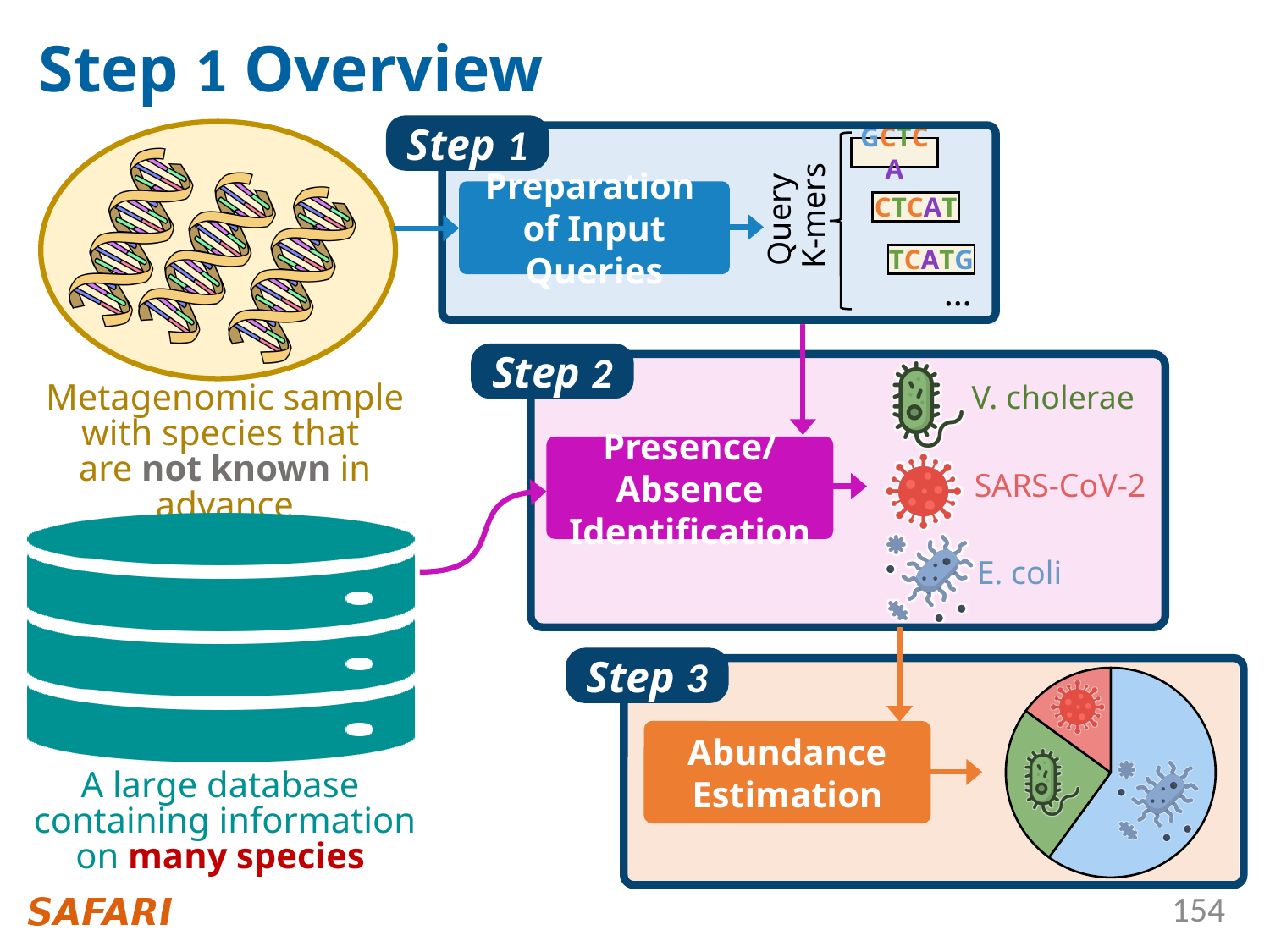
What kind of chart is shown in the Step 3 box? pie chart Which step's box contains the pie chart on the slide? Step 3 How many slices does the pie chart in the Step 3 box have? 3 What is the label of the box that points to the pie chart in Step 3? Abundance Estimation Which colour slice is the largest in the pie chart in the Step 3 box? blue In the pie chart in the Step 3 box, which species icon sits in the largest slice? E. coli